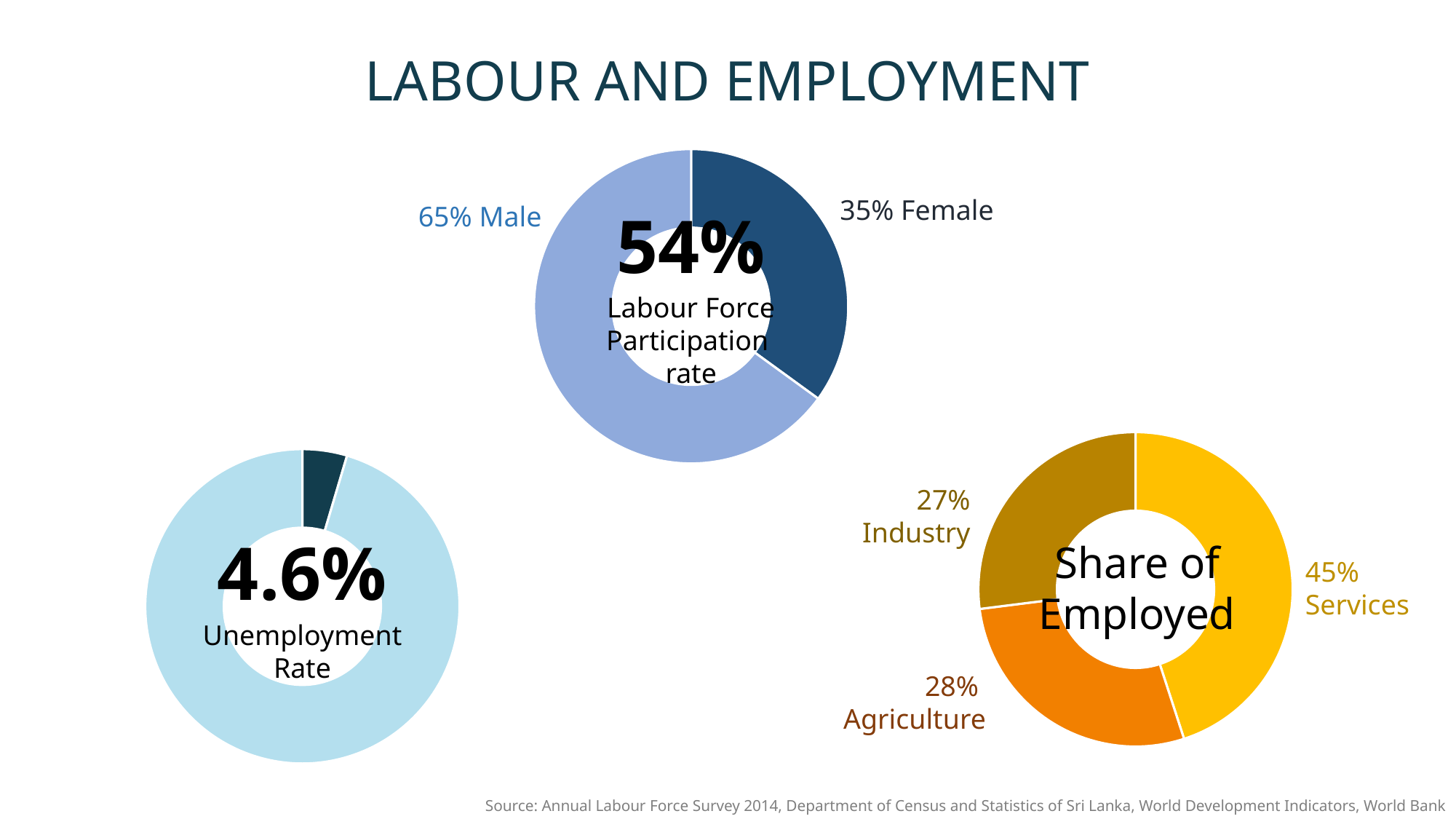
In the Share of Employed chart, what is the difference between the Services and Industry shares? 18% In the Labour Force Participation rate chart, what share is Female? 35% What is the Unemployment Rate shown in the bottom-left chart? 4.6% In the Share of Employed chart, which sector has the smallest share? Industry How many sectors are shown in the Share of Employed chart? 3 In the Share of Employed chart, what share is Agriculture? 28% What kind of chart is the Share of Employed chart? Donut (pie) chart What is the overall Labour Force Participation rate shown in the centre of the top chart? 54% In the Labour Force Participation rate chart, what is the difference between the Male and Female shares? 30% In the Share of Employed chart, which sector has the largest share? Services In the Labour Force Participation rate chart, what share is Male? 65% In the Share of Employed chart, what share is Services? 45%